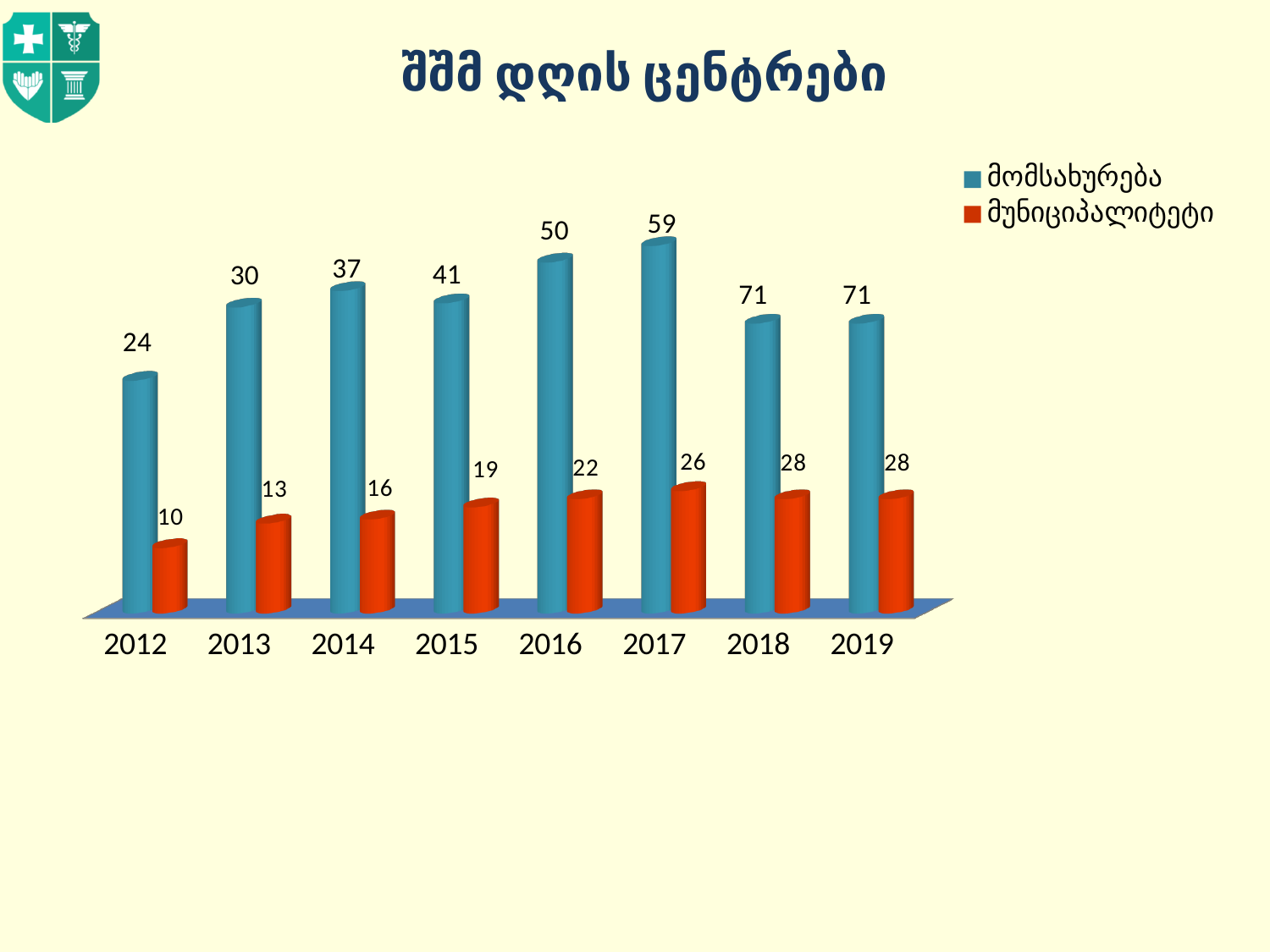
In which year is the value for მომსახურება lowest? 2012 How many years are shown on the x axis? 8 How many series does the legend list? 2 Which is larger in 2013, the value for მომსახურება or for მუნიციპალიტეტი? მომსახურება What is the value for მუნიციპალიტეტი in 2014? 16 What is the value for მომსახურება in 2012? 24 What type of chart is shown on the slide? bar chart What is the difference between the მომსახურება values for 2017 and 2016? 9 What is the value for მუნიციპალიტეტი in 2017? 26 What is the value for მომსახურება in 2016? 50 What is the difference between the მომსახურება and მუნიციპალიტეტი values in 2015? 22 In which year is the value for მუნიციპალიტეტი lowest? 2012